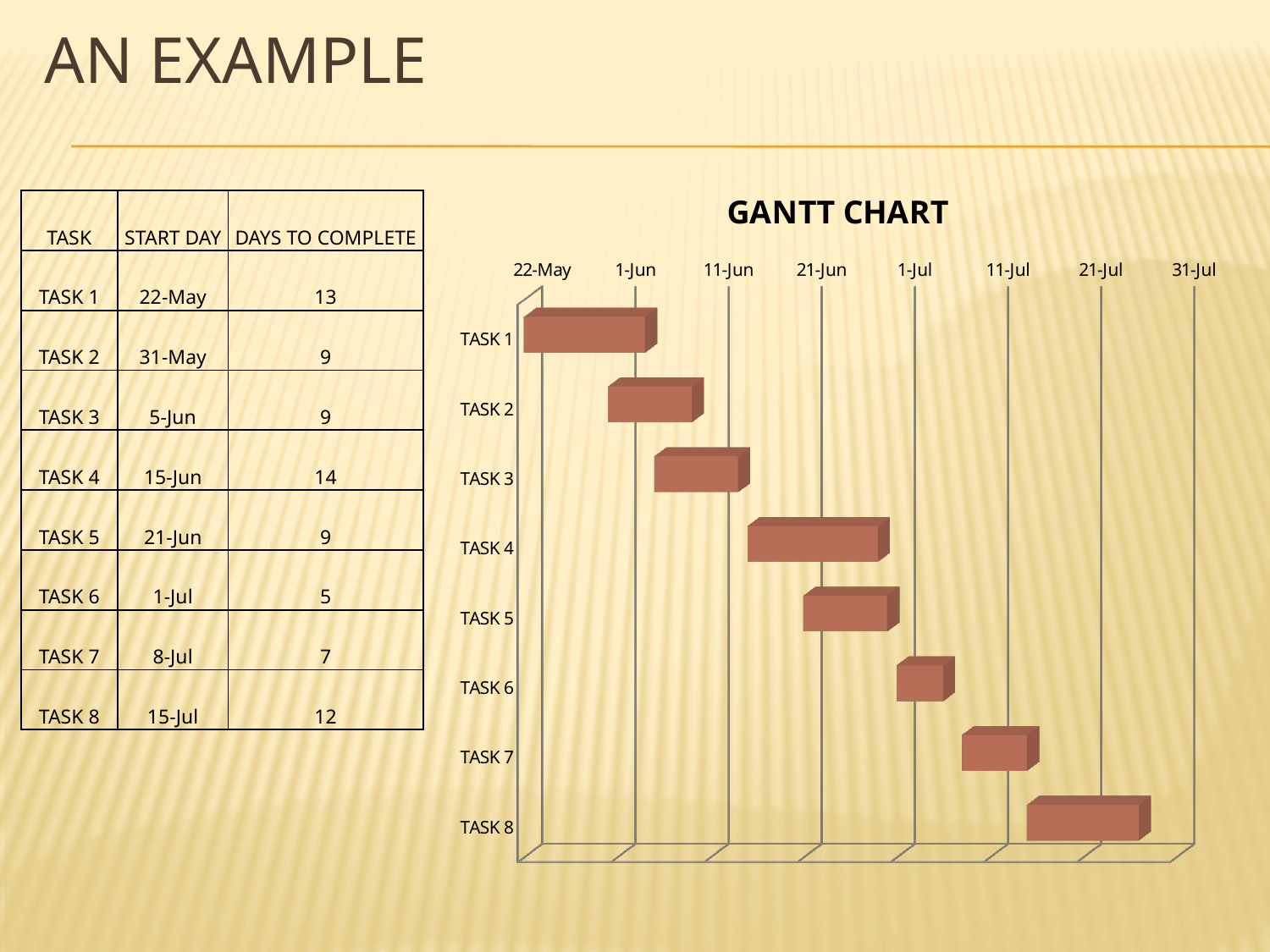
Does the bar for TASK 8 end before or after the 21-Jul tick on the GANTT CHART? after What is the first date tick shown on the GANTT CHART's horizontal axis? 22-May Which task has the shortest bar on the GANTT CHART? TASK 6 Going down the GANTT CHART from TASK 1 to TASK 8, do the bars start progressively later or earlier? later What is the title of the chart on the slide? GANTT CHART What kind of chart is the GANTT CHART? bar chart On what date does TASK 5 start, according to the slide? 21-Jun How many tasks are plotted on the GANTT CHART? 8 How many days does TASK 4 take to complete, according to the slide? 14 On what date does TASK 6 start, according to the slide? 1-Jul Which bar is longer on the GANTT CHART, TASK 8 or TASK 6? TASK 8 Does the bar for TASK 3 start before or after the 1-Jun tick on the GANTT CHART? after